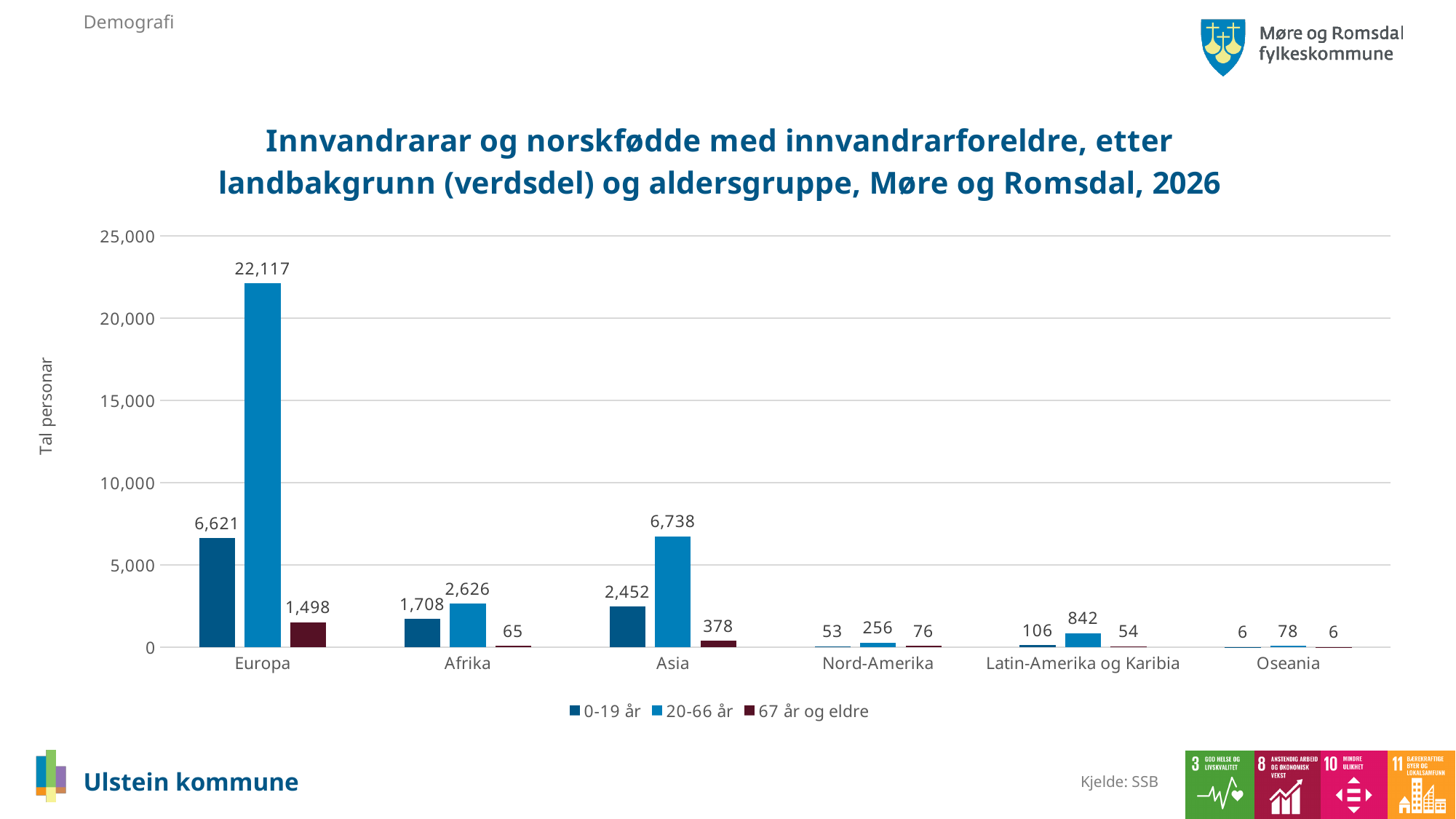
What is the total of the three age groups for Nord-Amerika? 385 What kind of chart is shown on the slide? bar chart What is the value for the 20-66 år series for Europa? 22,117 Which region has the highest value for the 20-66 år series? Europa Is the value for the 20-66 år series for Europa greater or less than 20,000? greater How many regions are shown on the x axis? 6 Which region has the lowest value for the 0-19 år series? Oseania What is the value for the 0-19 år series for Latin-Amerika og Karibia? 106 What is the value for the 67 år og eldre series for Asia? 378 What is the difference between the 20-66 år value and the 0-19 år value for Asia? 4,286 Which is larger: the 0-19 år value for Afrika or the 0-19 år value for Asia? Asia How many series does the legend list? 3